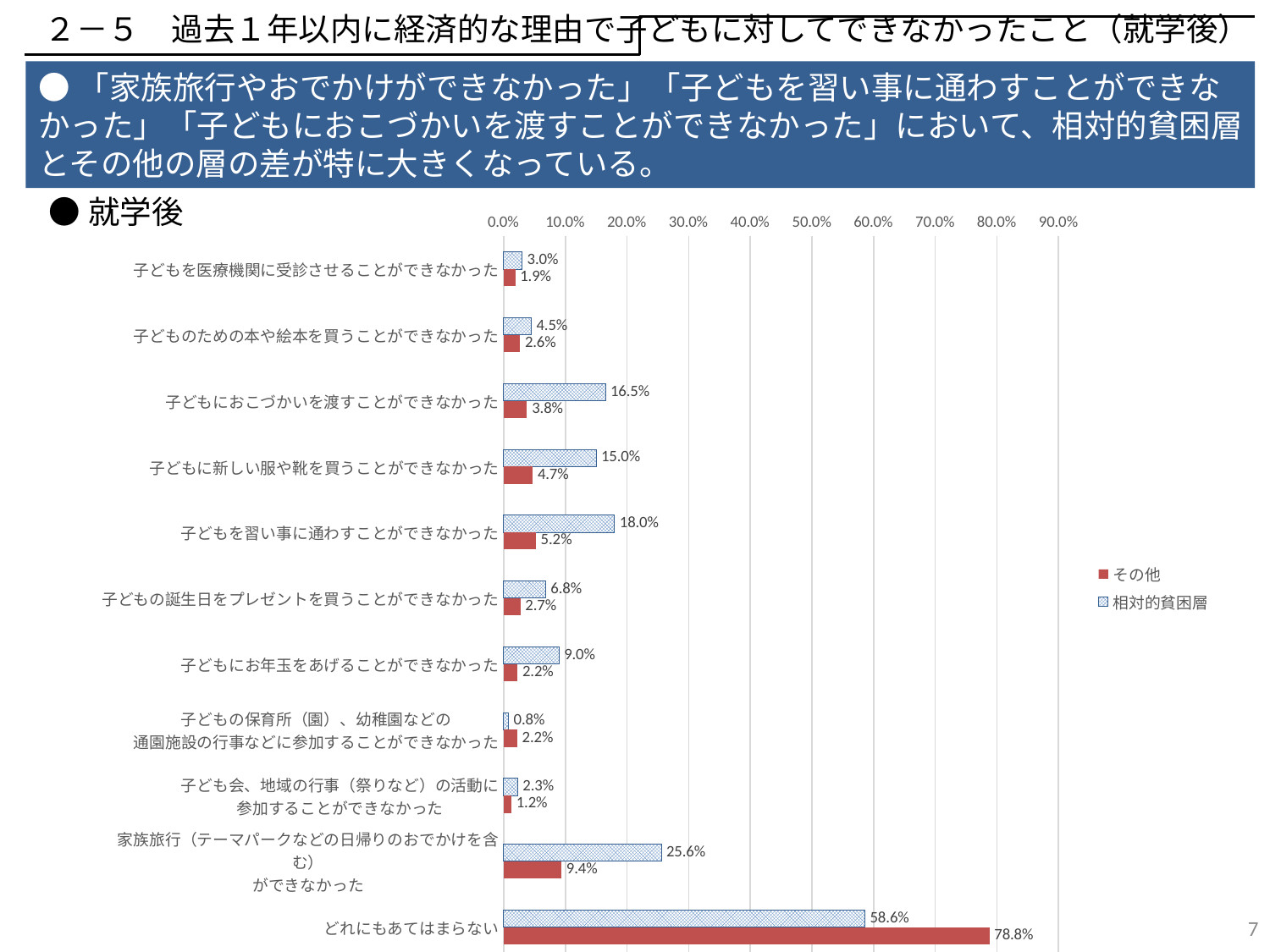
Is the value for 相対的貧困層 in the category どれにもあてはまらない greater or less than 50.0%? greater How many series does the legend list? 2 Which series is shown in red in the legend? その他 What kind of chart is shown on the slide? bar chart Which category has the highest value for その他? どれにもあてはまらない What is the value for 相対的貧困層 in the category 子どもにおこづかいを渡すことができなかった? 16.5% What is the difference between 相対的貧困層 and その他 in the category 子どもを習い事に通わすことができなかった? 12.8% What is the value for その他 in the category 家族旅行（テーマパークなどの日帰りのおでかけを含む）ができなかった? 9.4% Which category has the lowest value for 相対的貧困層? 子どもの保育所（園）、幼稚園などの通園施設の行事などに参加することができなかった How many categories are shown on the chart? 11 In the category どれにもあてはまらない, which series has the larger value, その他 or 相対的貧困層? その他 What is the value for 相対的貧困層 in the category 子どもを習い事に通わすことができなかった? 18.0%